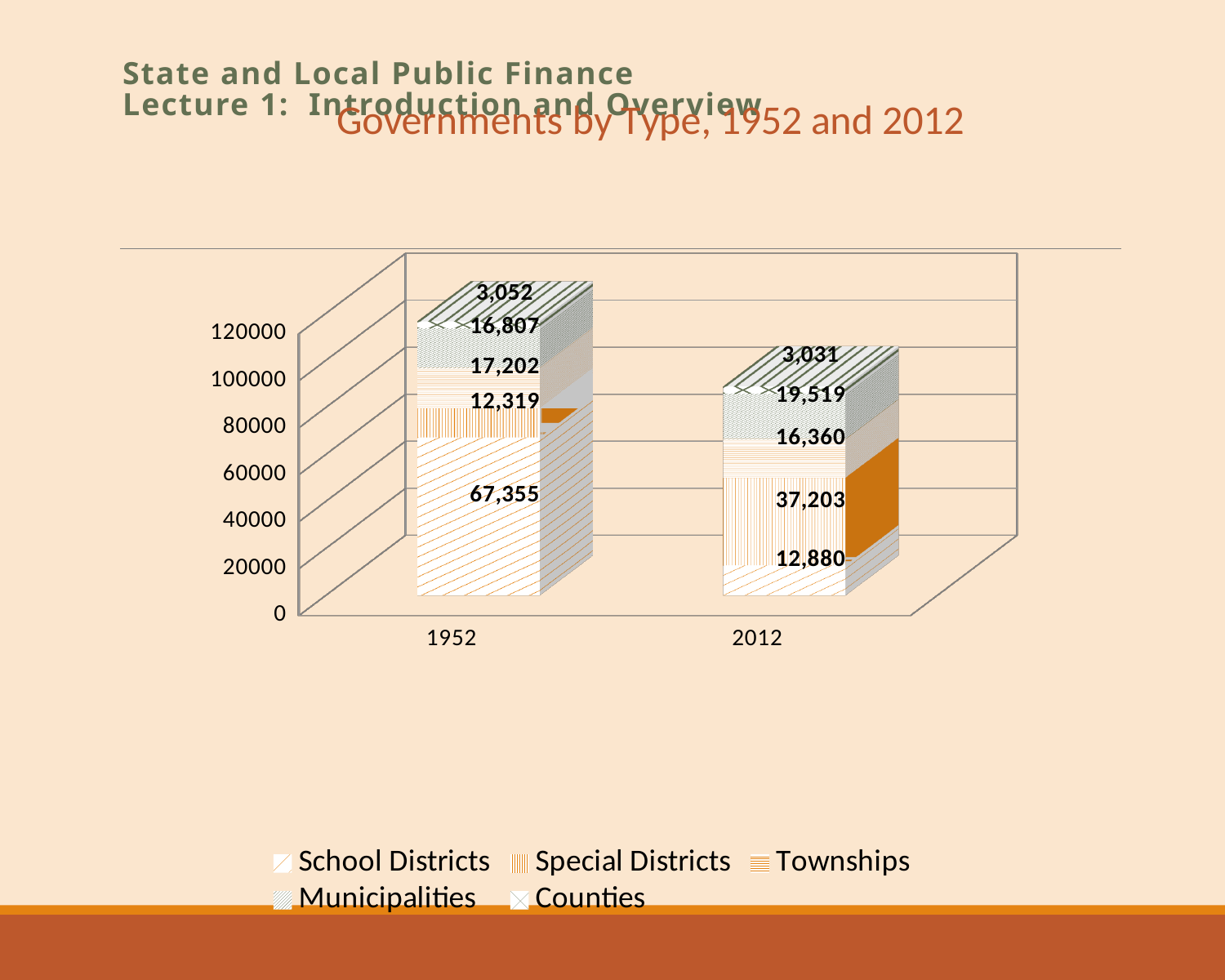
What is the number of Townships in 1952? 17,202 Which government type had the largest count in 1952? School Districts What is the number of Counties in 2012? 3,031 What is the number of School Districts in 1952? 67,355 What kind of chart is shown on the slide? Stacked bar chart Which is larger: Municipalities in 1952 or Municipalities in 2012? Municipalities in 2012 By how much did the number of School Districts fall from 1952 to 2012? 54,475 Which government type had the smallest count in 2012? Counties What is the number of Special Districts in 2012? 37,203 What is the total number of governments in the 2012 stacked bar? 88,993 How many years (categories) are shown on the x axis? 2 How many series does the legend list? 5